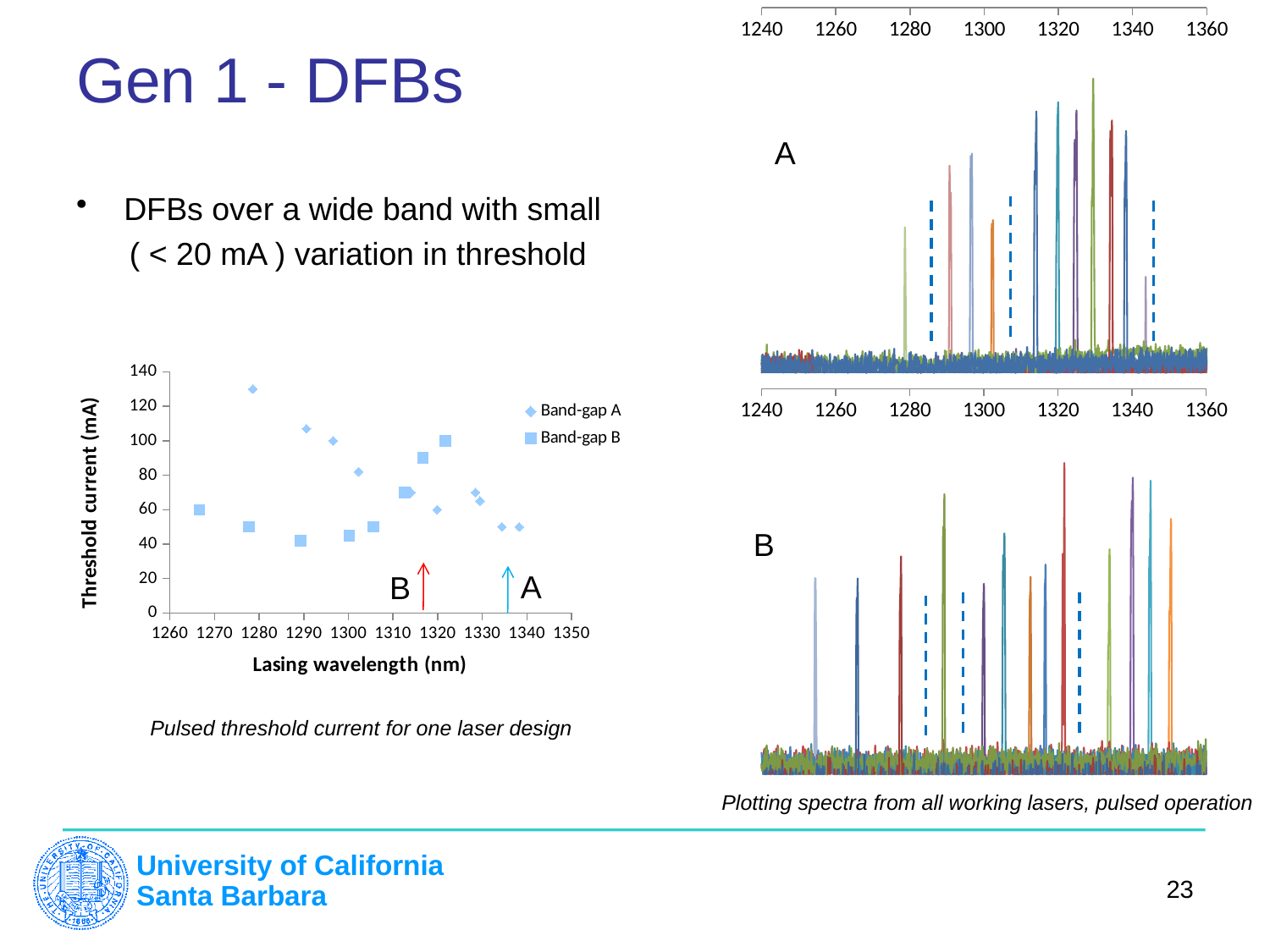
How many series does the legend of the threshold current chart list? 2 What are the two series named in the legend of the threshold current chart? Band-gap A and Band-gap B In the threshold current chart, is the Band-gap B point near 1320 nm greater or less than 80 mA? greater What wavelength range do the x axes of the spectra plots A and B on the right span? 1240 to 1360 In the threshold current chart, near 1320 nm, which series has the higher threshold current, Band-gap A or Band-gap B? Band-gap B In the threshold current chart, is the lowest Band-gap A point greater or less than 40 mA? greater In the threshold current chart, is the highest Band-gap A point greater or less than 120 mA? greater In the threshold current chart, which series reaches the highest threshold current? Band-gap A What kind of chart is the 'Threshold current (mA)' vs 'Lasing wavelength (nm)' chart? scatter chart In the threshold current chart, does the Band-gap B threshold current rise or fall between 1300 nm and 1320 nm? rise In the threshold current chart, does the Band-gap A threshold current generally rise or fall as lasing wavelength increases? fall